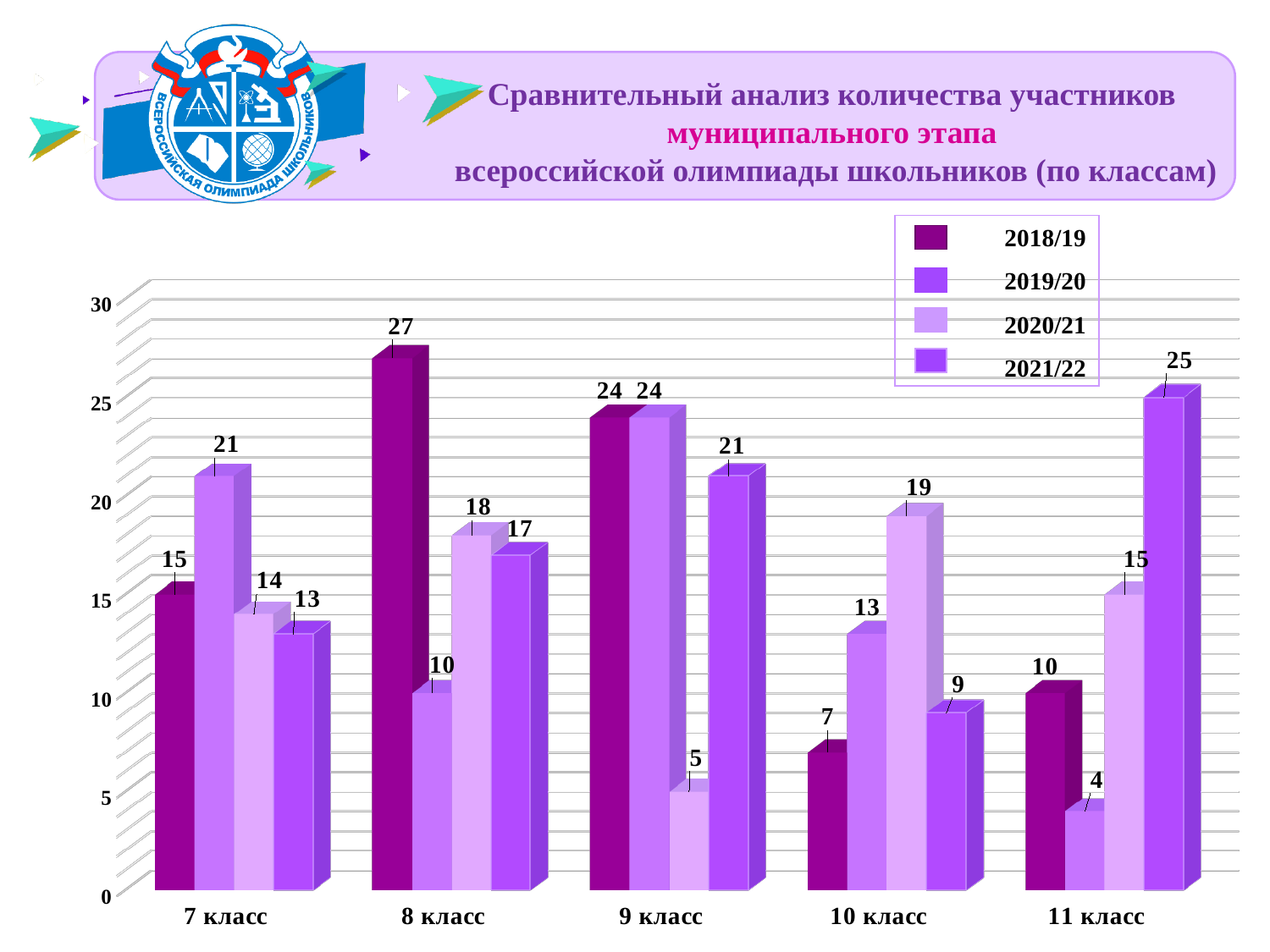
What is the value for 2021/22 in 11 класс? 25 What type of chart is shown on the slide? bar chart Which class has the lowest value for the 2018/19 series? 10 класс Does the value for 2021/22 in 11 класс rise or fall compared with 2021/22 in 10 класс? rise How many class categories are shown on the x axis? 5 What is the value for 2018/19 in 8 класс? 27 What is the difference between the 2018/19 and 2019/20 values in 8 класс? 17 Which is larger in 10 класс: the 2020/21 value or the 2021/22 value? 2020/21 Which legend entry is shown in the darkest purple colour? 2018/19 Which class has the highest value for the 2019/20 series? 9 класс How many series does the legend list? 4 What is the value for 2020/21 in 9 класс? 5